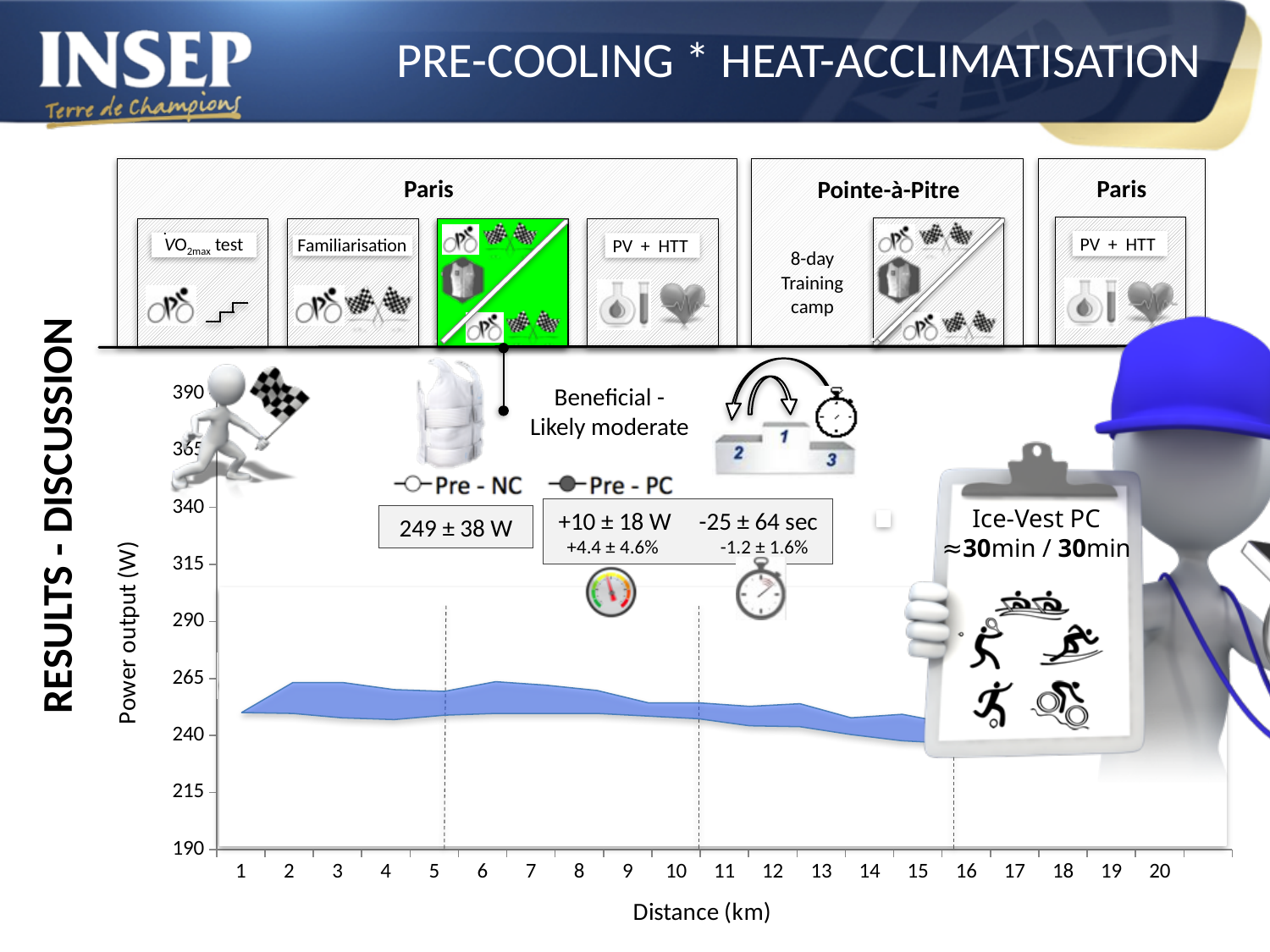
Is the power output at 5 km greater or less than 290 W? less How many series does the chart legend list? 2 What is the highest value shown on the vertical axis of the chart? 390 Is the power output at 12 km greater or less than 315 W? less What are the two series named in the chart legend? Pre - NC and Pre - PC Is the power output at 3 km greater or less than 215 W? greater Between 6 km and 15 km, does the plotted power output rise or fall? fall What is the lowest value shown on the vertical axis of the chart? 190 What mean power output value is printed in the box on the chart? 249 ± 38 W How many distance values are labelled along the horizontal axis of the chart? 20